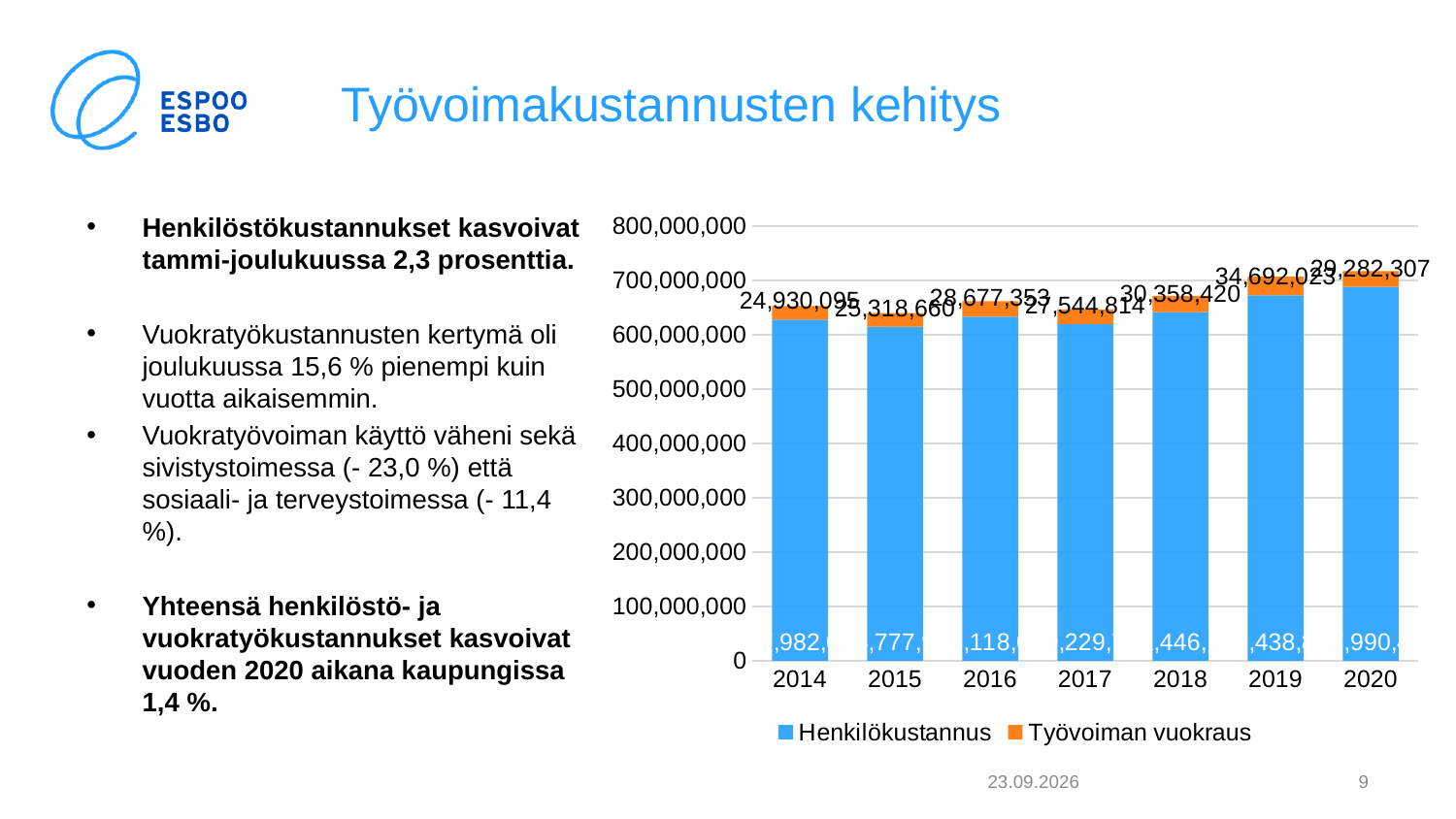
What is the value of Työvoiman vuokraus in 2020? 29,282,307 What is the value of Työvoiman vuokraus in 2018? 30,358,420 How many years are shown on the x axis of the chart? 7 Does the Henkilökustannus series generally rise or fall from 2014 to 2020? rise Is the Henkilökustannus value for 2020 greater or less than 700,000,000? less Is the total height of the 2014 bar greater or less than 600,000,000? greater What type of chart is shown on the slide? bar chart In which year is the Työvoiman vuokraus value highest? 2019 How many series does the chart legend list? 2 Which is larger, the Henkilökustannus value for 2014 or for 2020? 2020 Which series is shown in orange in the chart? Työvoiman vuokraus What is the title of the slide containing the chart? Työvoimakustannusten kehitys